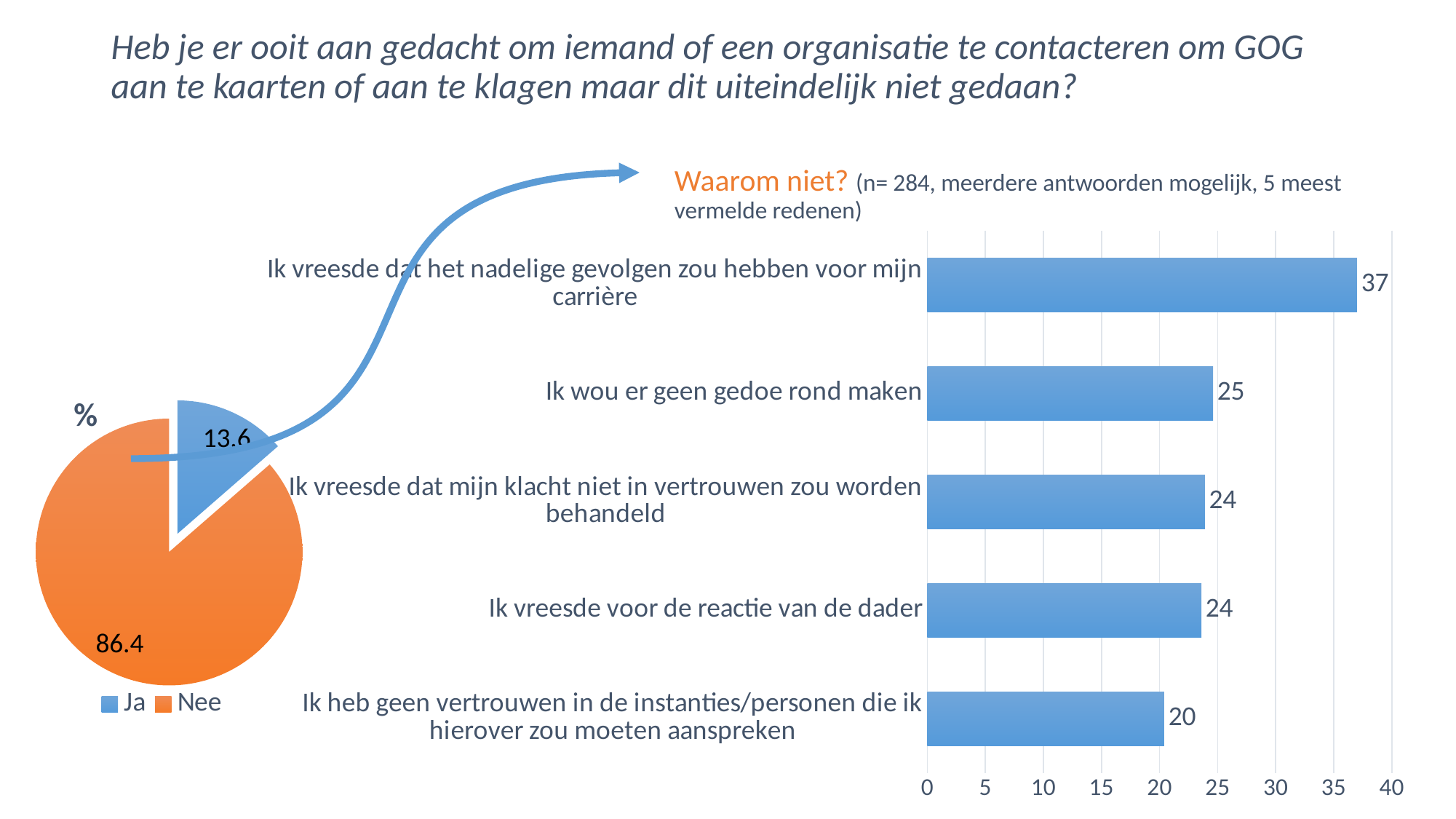
In the "Waarom niet?" chart, what is the difference between the value for "Ik vreesde dat het nadelige gevolgen zou hebben voor mijn carrière" and the value for "Ik vreesde voor de reactie van de dader"? 13 In the "Waarom niet?" chart, which reason has the lowest value? Ik heb geen vertrouwen in de instanties/personen die ik hierover zou moeten aanspreken In the pie chart on the left, which slice is larger, "Ja" or "Nee"? Nee What kind of chart is the "Waarom niet?" chart? Bar chart In the "Waarom niet?" chart, what is the value for "Ik wou er geen gedoe rond maken"? 25 In the pie chart on the left, how many entries does the legend list? 2 In the "Waarom niet?" chart, how many reasons are shown? 5 In the "Waarom niet?" chart, which reason has the highest value? Ik vreesde dat het nadelige gevolgen zou hebben voor mijn carrière In the "Waarom niet?" chart, what is the value for "Ik heb geen vertrouwen in de instanties/personen die ik hierover zou moeten aanspreken"? 20 In the pie chart on the left, what is the value for "Ja"? 13.6 In the "Waarom niet?" chart, what is the value for "Ik vreesde dat mijn klacht niet in vertrouwen zou worden behandeld"? 24 In the pie chart on the left, what is the value for "Nee"? 86.4